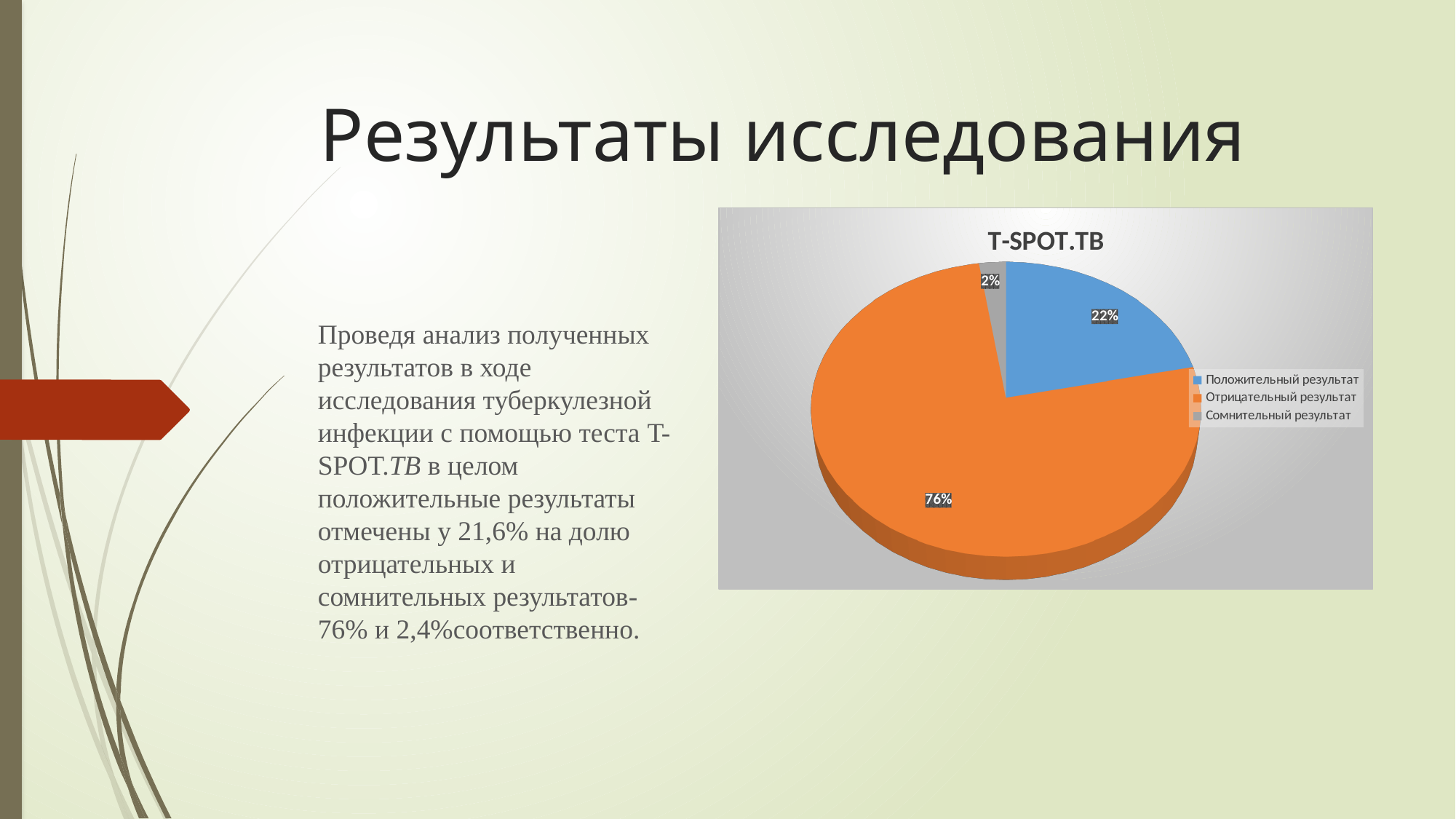
What is the difference in percentage points between Положительный результат and Сомнительный результат? 20% Which category has the smallest slice of the pie? Сомнительный результат How many categories does the legend list? 3 What kind of chart is shown on the slide? pie chart What share of the pie is labelled for Положительный результат? 22% Which is larger, the slice for Положительный результат or the slice for Сомнительный результат? Положительный результат What colour is the slice for Отрицательный результат? orange What is the difference in percentage points between Отрицательный результат and Положительный результат? 54% What is the title of the chart? T-SPOT.TB What share of the pie is labelled for Отрицательный результат? 76% Which category has the largest slice of the pie? Отрицательный результат What share of the pie is labelled for Сомнительный результат? 2%